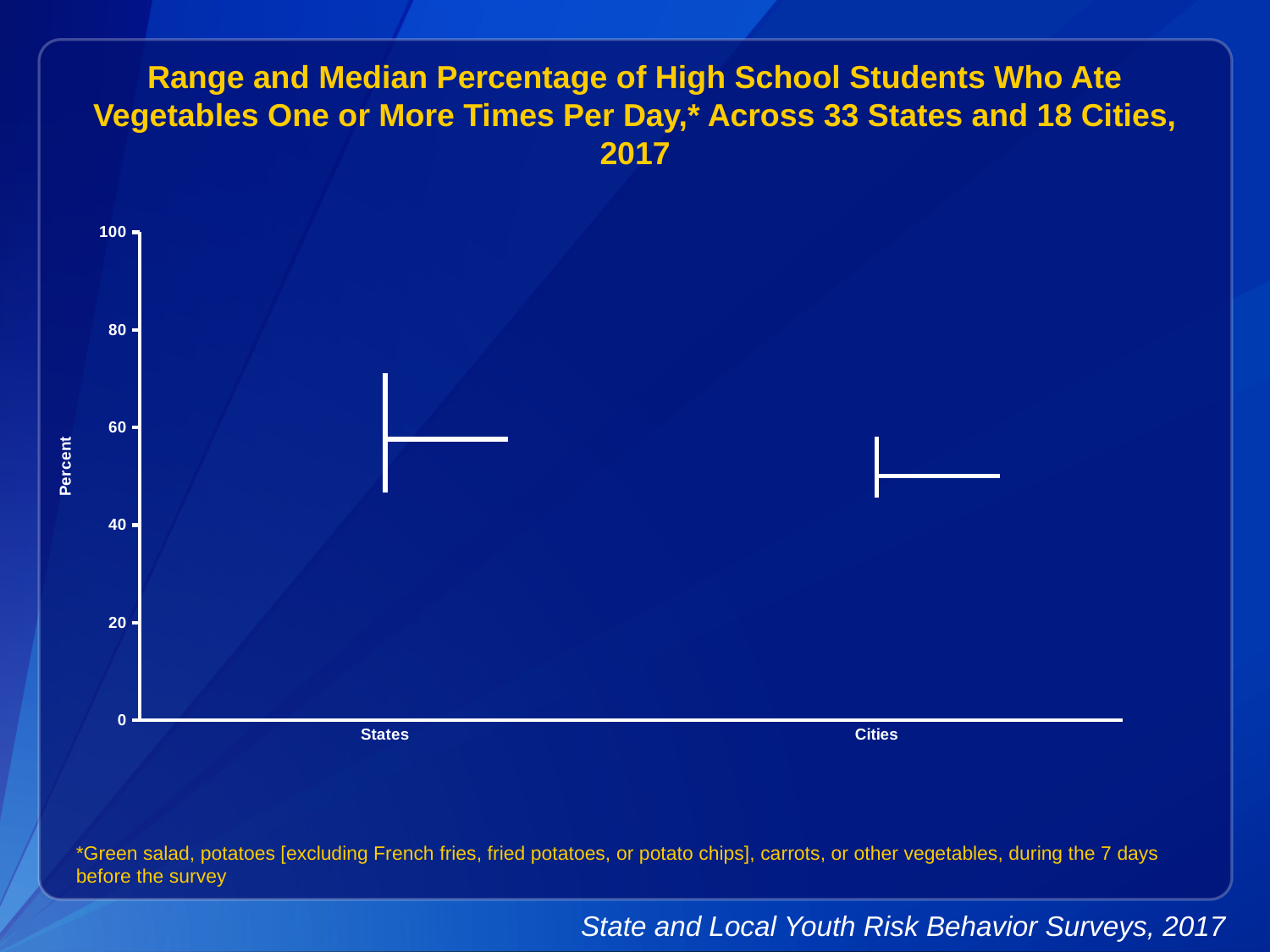
Is the median value for States greater or less than 40? greater Is the top of the range for Cities greater or less than 80? less Is the top of the range for States greater or less than 60? greater What are the two categories shown on the x axis? States and Cities Which category has the higher top of its range, States or Cities? States Which category has the higher median value, States or Cities? States What is the label of the y axis? Percent How many categories are shown on the x axis of the chart? 2 What is the highest value shown on the y axis? 100